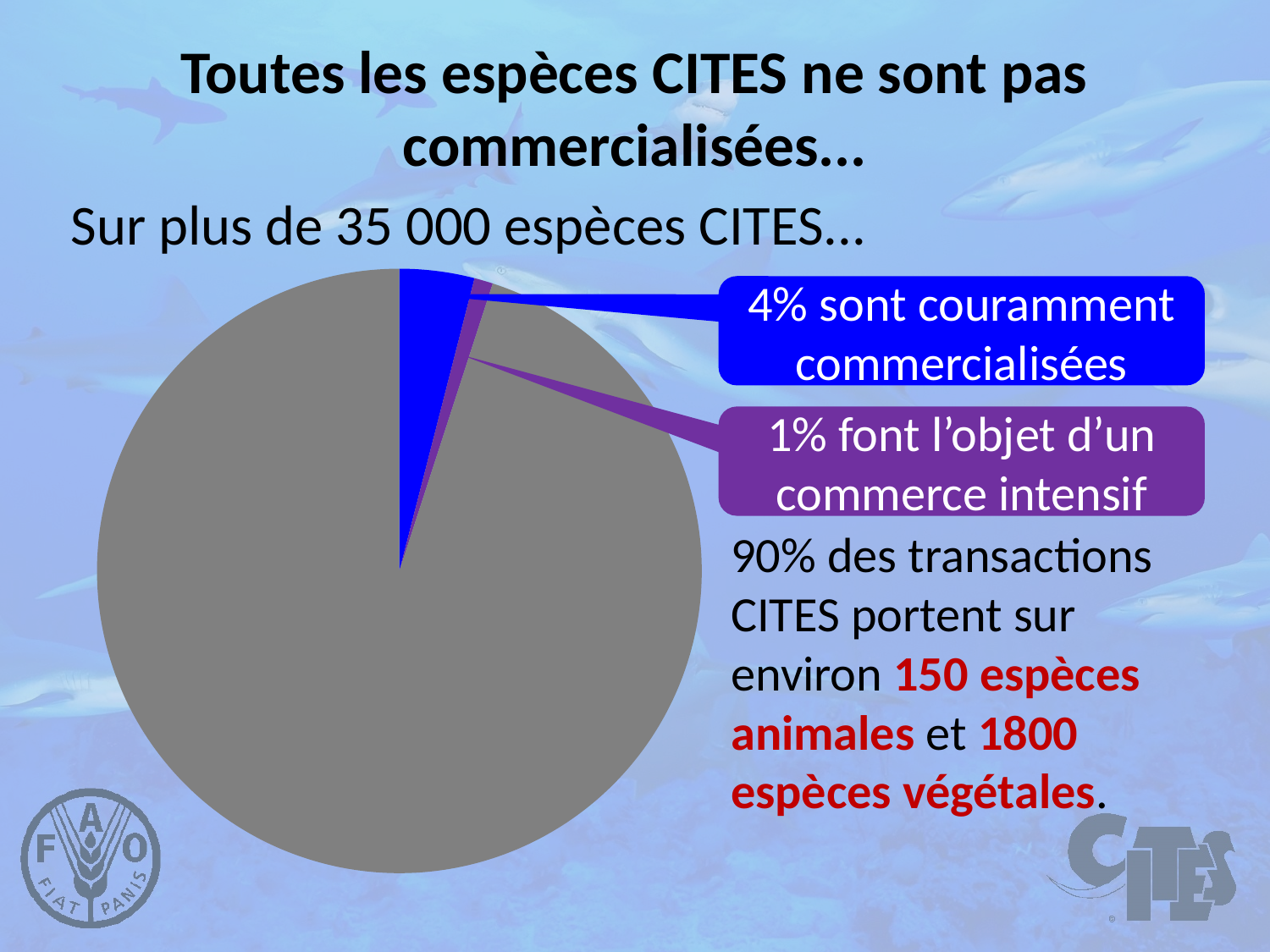
What kind of chart is shown on the slide? pie chart What colour is the slice representing the 1% of species subject to intensive trade? purple Which colour slice is the largest in the pie chart? grey What percentage of CITES species are subject to intensive trade (commerce intensif) according to the pie chart? 1% What is the difference in percentage points between the commonly traded slice and the intensive trade slice? 3 percentage points What colour is the slice representing the 4% of species commonly traded? blue Which is larger: the share of species commonly traded or the share subject to intensive trade? commonly traded (4%) How many slices does the pie chart have? 3 Which slice of the pie chart is the smallest? the purple slice (1% commerce intensif) What percentage of CITES species are commonly traded (couramment commercialisées) according to the pie chart? 4%